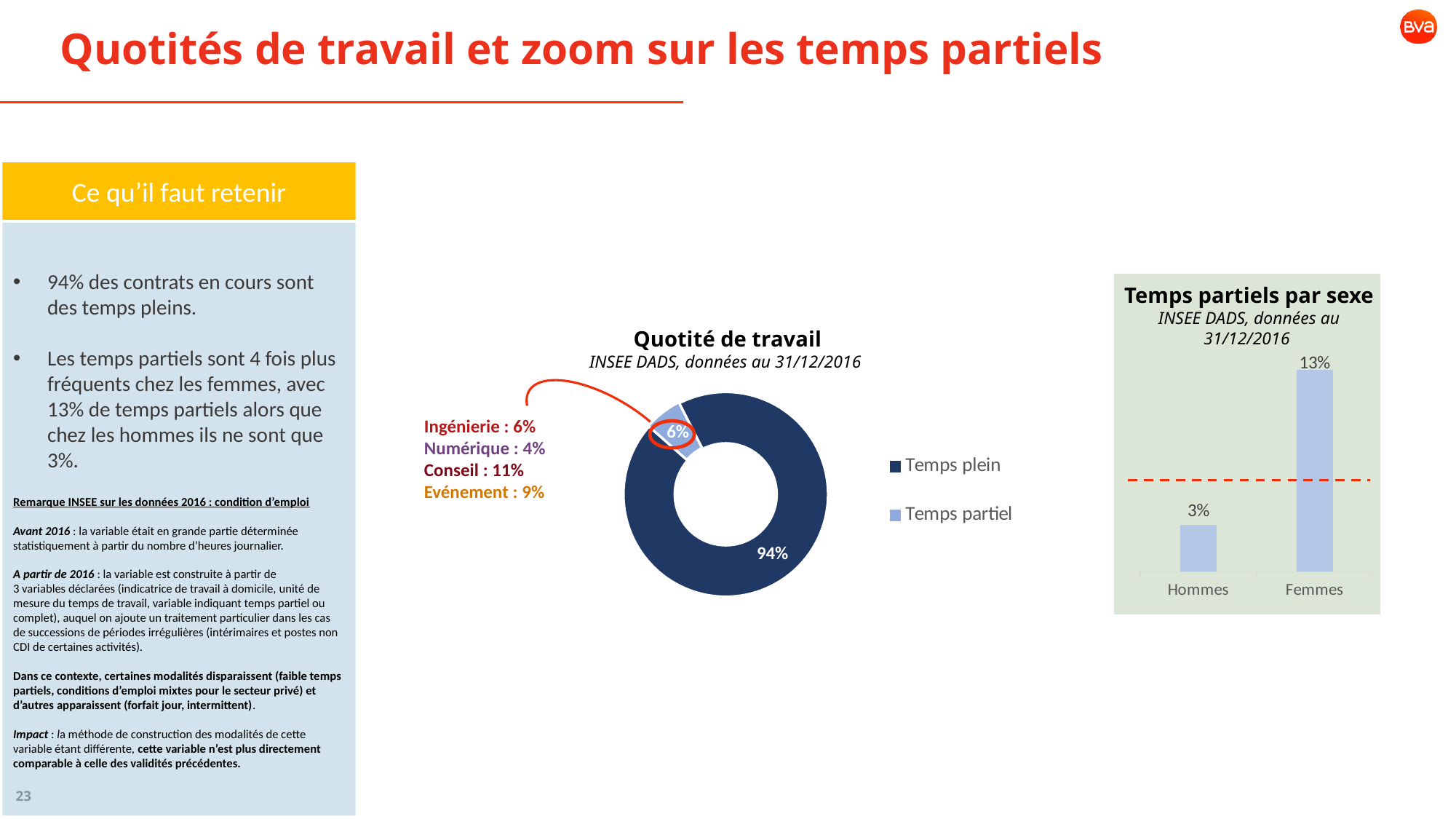
In the 'Temps partiels par sexe' chart, which category has the higher value? Femmes What kind of chart is 'Temps partiels par sexe'? Bar chart In the 'Temps partiels par sexe' chart, what is the value for Femmes? 13% In the 'Temps partiels par sexe' chart, what is the value for Hommes? 3% In the 'Quotité de travail' chart, what is the difference between the Temps plein and Temps partiel shares? 88 percentage points How many categories are shown in the 'Temps partiels par sexe' chart? 2 In the 'Temps partiels par sexe' chart, what is the difference between Femmes and Hommes? 10 percentage points What kind of chart is 'Quotité de travail'? Pie (donut) chart In the 'Quotité de travail' chart, what share is Temps partiel? 6% In the 'Quotité de travail' chart, which category has the largest share? Temps plein In the 'Quotité de travail' chart, what share is Temps plein? 94% How many series does the legend of the 'Quotité de travail' chart list? 2